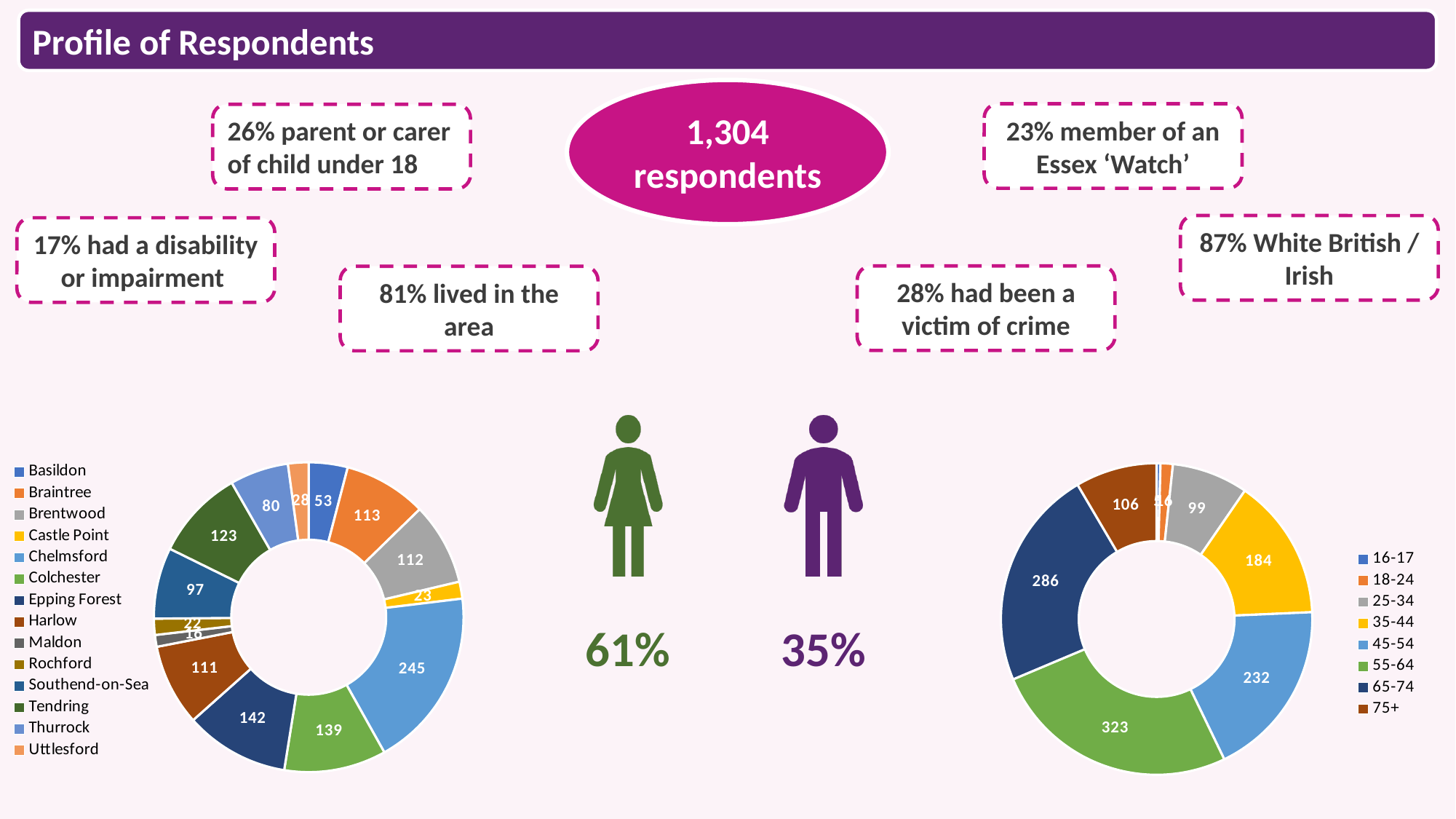
In the right doughnut chart of age groups, what is the value for 35-44? 184 In the right doughnut chart of age groups, which age group has the highest value? 55-64 In the right doughnut chart of age groups, what is the difference between the values for 65-74 and 45-54? 54 In the left doughnut chart of districts, which district has the highest value? Chelmsford In the right doughnut chart of age groups, what is the value for 55-64? 323 In the left doughnut chart of districts, what is the difference between the values for Epping Forest and Colchester? 3 How many districts are listed in the legend of the left doughnut chart? 14 In the left doughnut chart of districts, which district has the lowest value? Maldon In the left doughnut chart of districts, which is larger, Tendring or Southend-on-Sea? Tendring In the left doughnut chart of districts, what is the value for Harlow? 111 What type of chart is the right chart showing age groups? Doughnut chart In the left doughnut chart of districts, what is the value for Chelmsford? 245